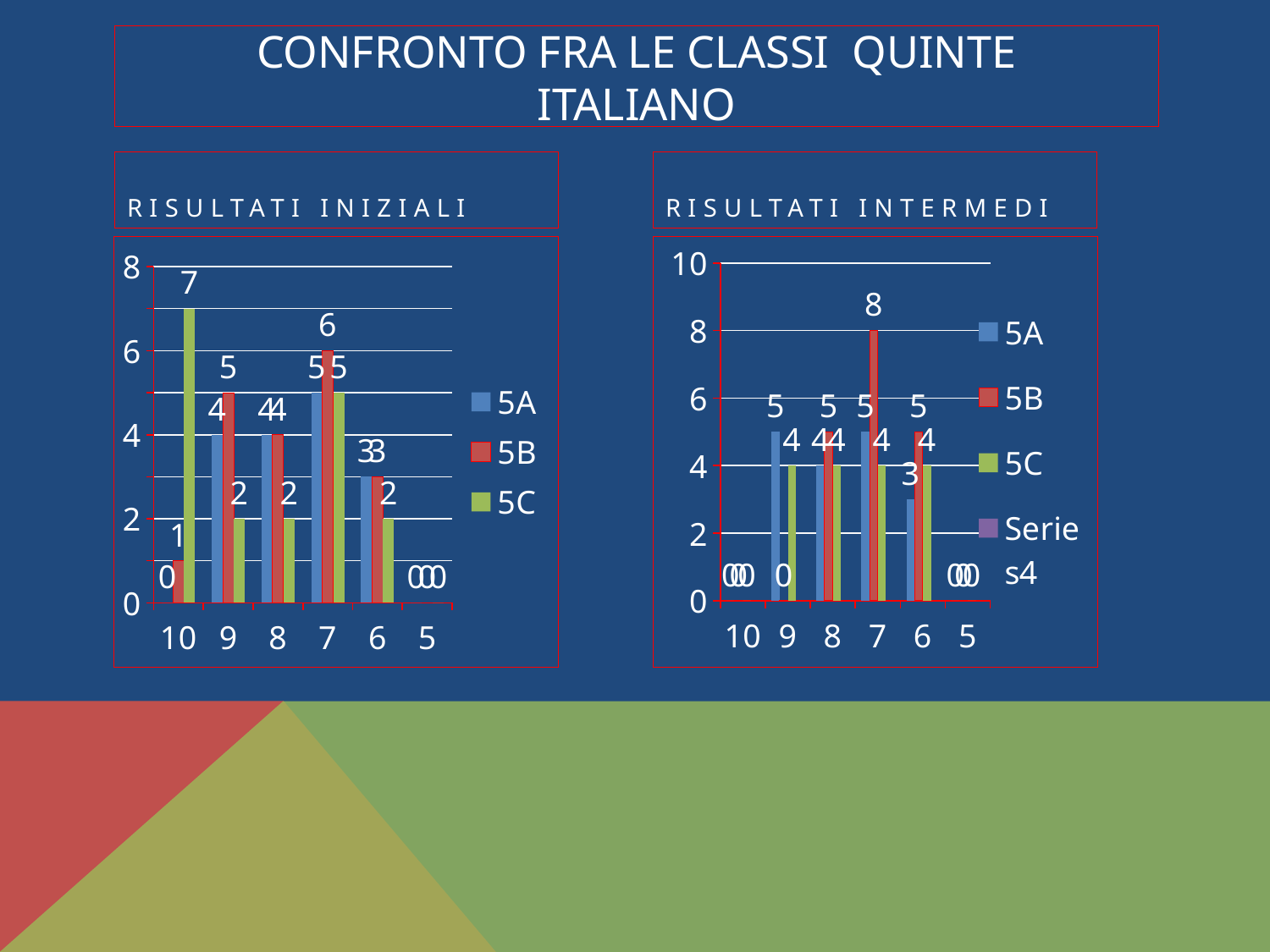
In the RISULTATI INIZIALI chart, what is the difference between the 5C value and the 5B value at category 10? 6 In the RISULTATI INTERMEDI chart, which series has the highest value at category 7? 5B In the RISULTATI INTERMEDI chart, what is the difference between the 5B value and the 5A value at category 7? 3 In the RISULTATI INTERMEDI chart, what is the value for 5B at category 9? 0 In the RISULTATI INTERMEDI chart, which is larger at category 9: the value for 5A or the value for 5C? 5A In the RISULTATI INIZIALI chart, what is the value for 5C at category 10? 7 In the RISULTATI INIZIALI chart, which category has the highest value for 5C? 10 In the RISULTATI INTERMEDI chart, what is the value for 5B at category 7? 8 What kind of chart is the RISULTATI INIZIALI chart? Bar chart How many series does the legend of the RISULTATI INIZIALI chart list? 3 How many entries does the legend of the RISULTATI INTERMEDI chart list? 4 In the RISULTATI INIZIALI chart, what is the value for 5B at category 7? 6